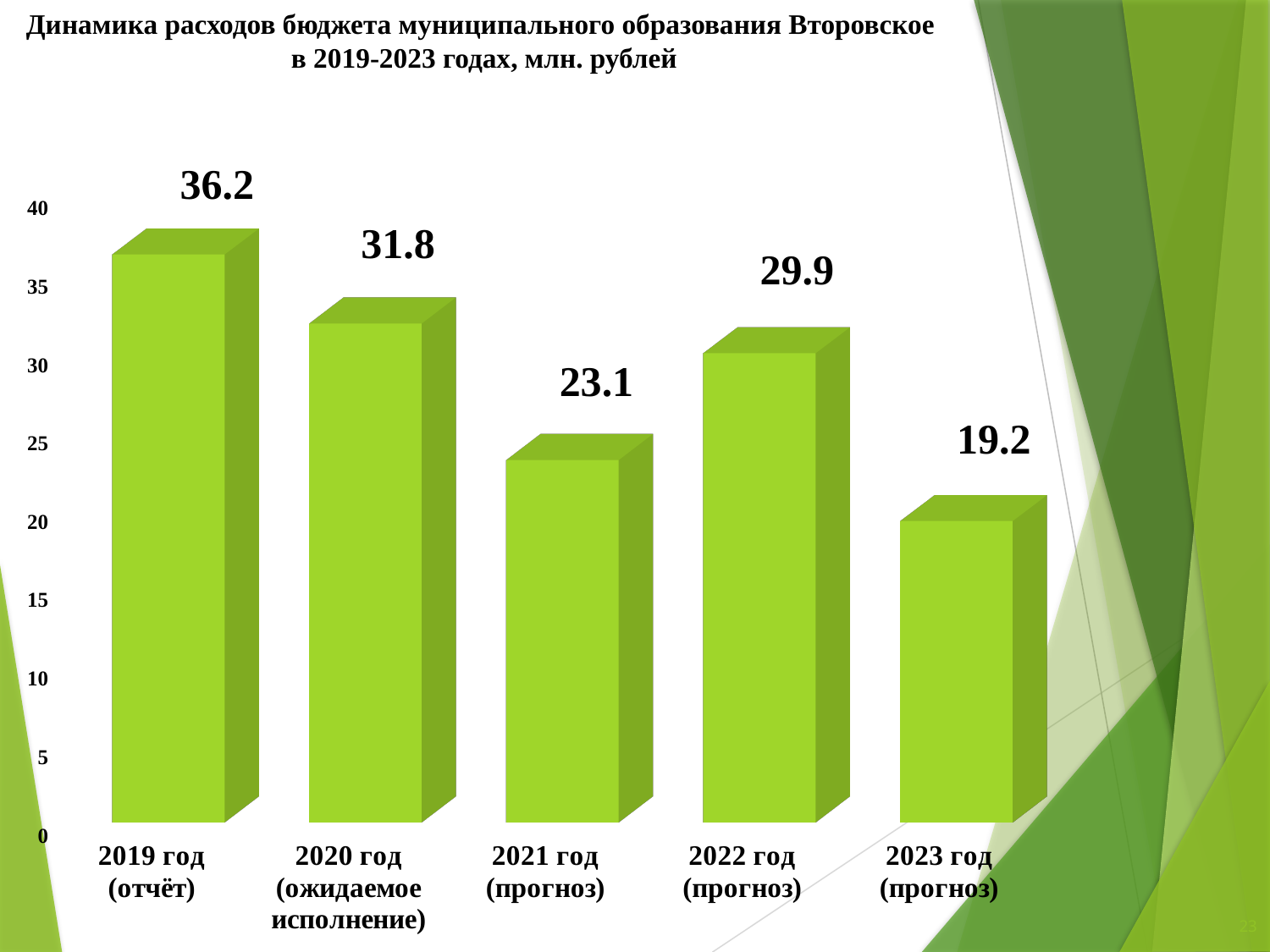
Which is larger, the value for 2021 год or the value for 2022 год? 2022 год Is the value for 2020 год greater or less than 30? greater What kind of chart is shown on the slide? bar chart Which year has the highest expenditure value? 2019 год (отчёт) What is the value shown for 2021 год (прогноз)? 23.1 What is the budget expenditure value for 2019 год (отчёт)? 36.2 Which year has the lowest expenditure value? 2023 год (прогноз) What is the difference between the values for 2019 год and 2020 год? 4.4 How many years (categories) are shown on the chart? 5 What is the difference between the values for 2022 год and 2023 год? 10.7 What is the value shown for 2023 год (прогноз)? 19.2 In what units are the values on the chart expressed, according to the title? млн. рублей